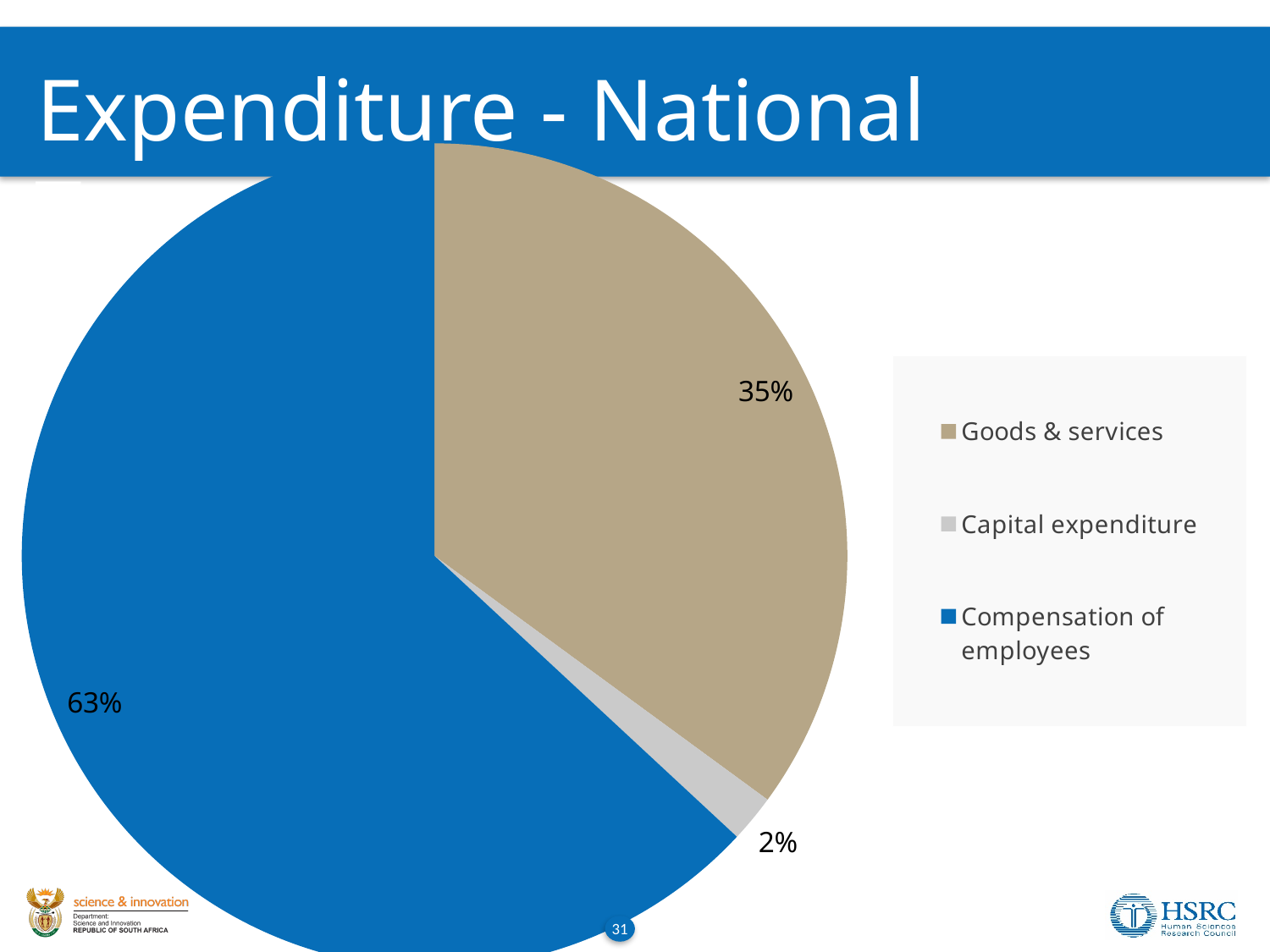
Which category has the smallest share of the pie? Capital expenditure What colour is the Compensation of employees slice? blue What share of expenditure is Goods & services? 35% Which category has the largest share of the pie? Compensation of employees What share of expenditure is Capital expenditure? 2% How many categories does the pie chart have? 3 What kind of chart is shown on the slide? pie chart What is the difference in percentage points between Compensation of employees and Goods & services? 28 What share of expenditure is Compensation of employees? 63% Which is larger, Goods & services or Capital expenditure? Goods & services What is the difference in percentage points between Goods & services and Capital expenditure? 33 What is the title of the slide containing the chart? Expenditure - National